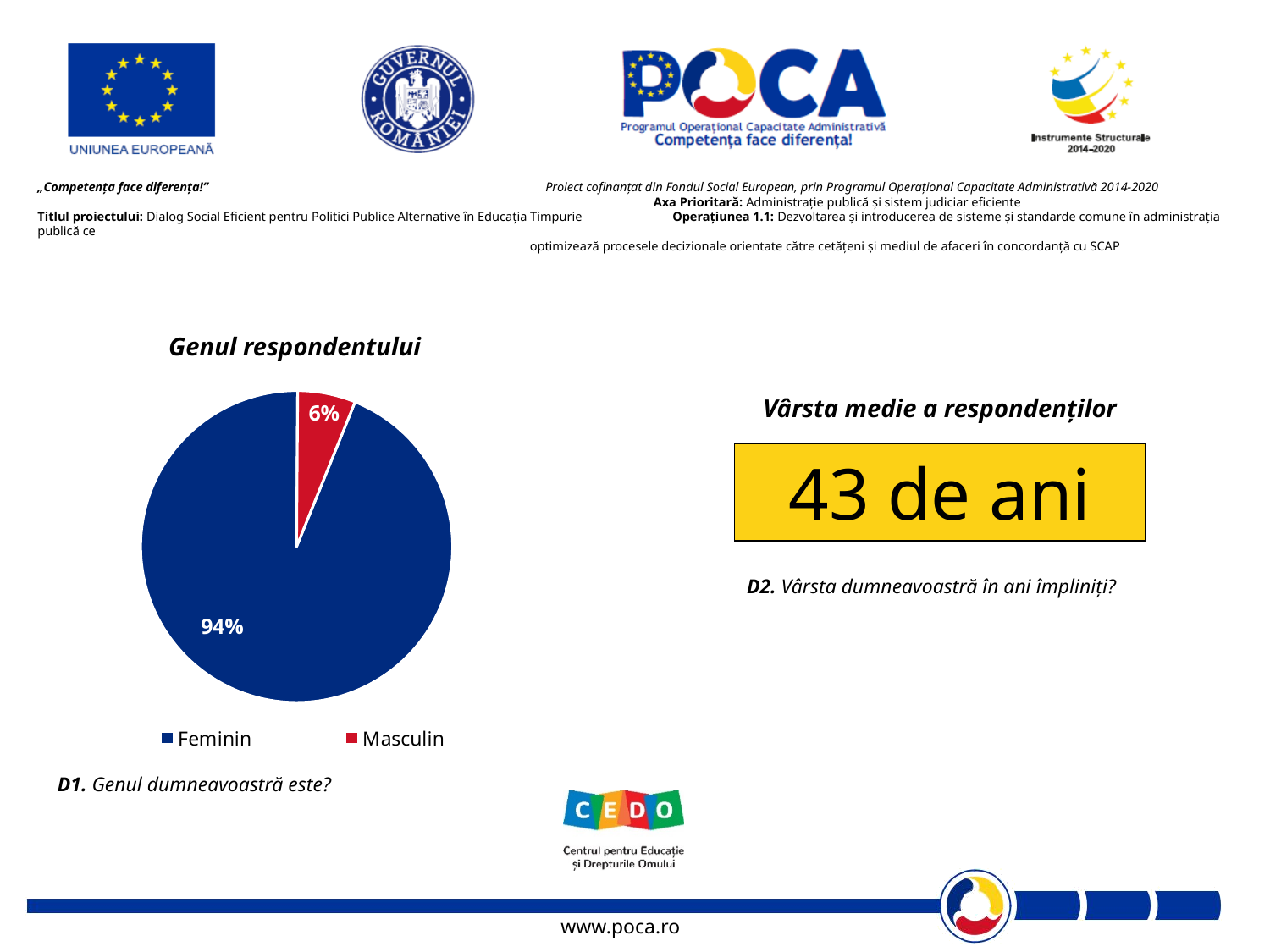
Which category has the smallest share in the "Genul respondentului" pie chart? Masculin How many categories does the "Genul respondentului" pie chart have? 2 What type of chart is shown under the title "Genul respondentului"? pie chart Which category has the largest share in the "Genul respondentului" pie chart? Feminin What is the difference in percentage points between Feminin and Masculin in the "Genul respondentului" chart? 88 Which is larger in the "Genul respondentului" chart, Feminin or Masculin? Feminin How many entries does the legend of the "Genul respondentului" chart list? 2 What is the title of the pie chart on the slide? Genul respondentului What colour is the Masculin slice in the "Genul respondentului" pie chart? red What percentage of respondents are Feminin in the "Genul respondentului" chart? 94% What percentage of respondents are Masculin in the "Genul respondentului" chart? 6% What is the share of the Feminin slice in the "Genul respondentului" pie chart? 94%